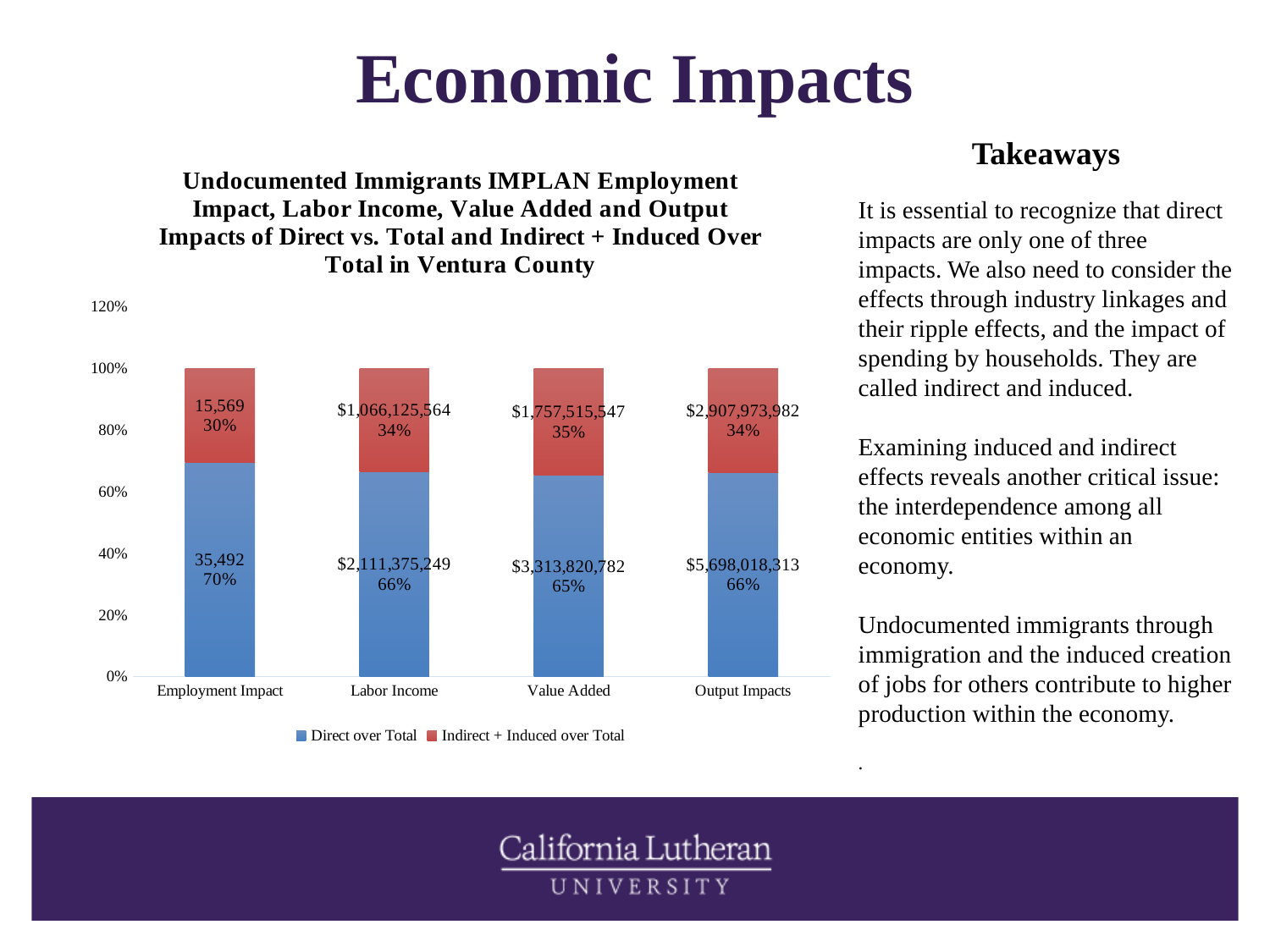
What value is labelled for Indirect + Induced over Total in the Employment Impact bar? 15,569 How many categories are shown on the x axis of the chart? 4 What dollar value is labelled for Direct over Total in the Labor Income bar? $2,111,375,249 Which series is shown in red in the chart? Indirect + Induced over Total Which category has the lowest Direct over Total percentage? Value Added How many series does the chart's legend list? 2 What kind of chart is shown on the slide? Stacked bar chart What percentage is shown for Direct over Total in the Employment Impact bar? 70% What is the difference in percentage points between the Direct over Total share and the Indirect + Induced over Total share for Employment Impact? 40 What dollar value is labelled for Indirect + Induced over Total in the Output Impacts bar? $2,907,973,982 What percentage is shown for Indirect + Induced over Total in the Value Added bar? 35% Which category has the highest Direct over Total percentage? Employment Impact